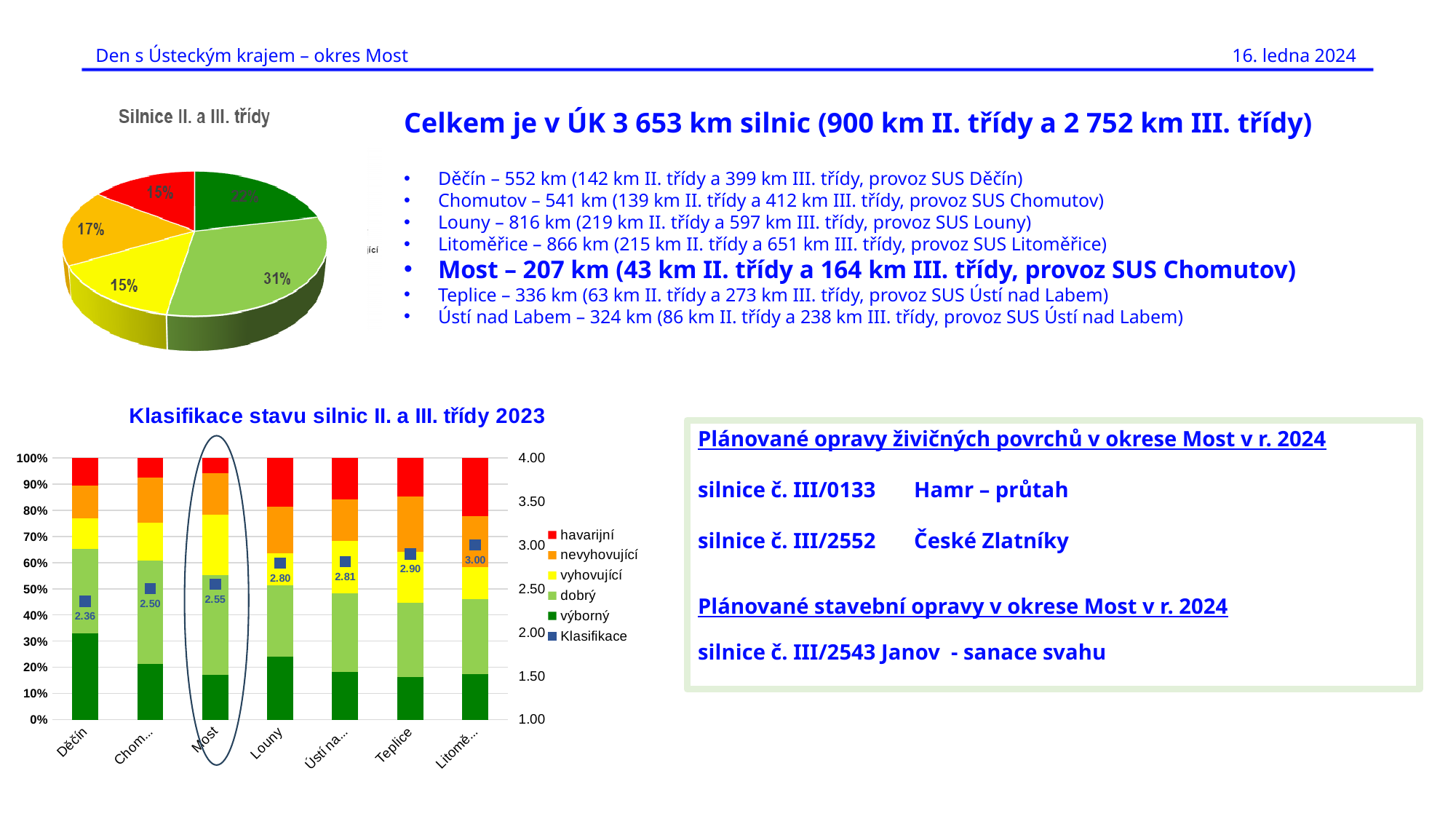
On the chart 'Klasifikace stavu silnic II. a III. třídy 2023', is the 'výborný' share for Děčín greater or less than 30%? greater On the chart 'Klasifikace stavu silnic II. a III. třídy 2023', what is the Klasifikace value for Teplice? 2.90 On the chart 'Klasifikace stavu silnic II. a III. třídy 2023', what is the Klasifikace value for Most? 2.55 On the chart 'Klasifikace stavu silnic II. a III. třídy 2023', do the Klasifikace values rise or fall from left to right along the x axis? Rise On the chart 'Klasifikace stavu silnic II. a III. třídy 2023', what is the Klasifikace value for Děčín? 2.36 On the chart 'Klasifikace stavu silnic II. a III. třídy 2023', which district has the lowest Klasifikace value? Děčín What kind of chart is 'Silnice II. a III. třídy' in the top left of the slide? Pie chart On the chart 'Klasifikace stavu silnic II. a III. třídy 2023', what is the difference between the Klasifikace values for Most and Děčín? 0.19 On the chart 'Klasifikace stavu silnic II. a III. třídy 2023', which has the higher Klasifikace value, Louny or Most? Louny What kind of chart is 'Klasifikace stavu silnic II. a III. třídy 2023'? Stacked bar chart On the chart 'Klasifikace stavu silnic II. a III. třídy 2023', how many entries does the legend list? 6 On the chart 'Klasifikace stavu silnic II. a III. třídy 2023', how many districts are shown on the x axis? 7